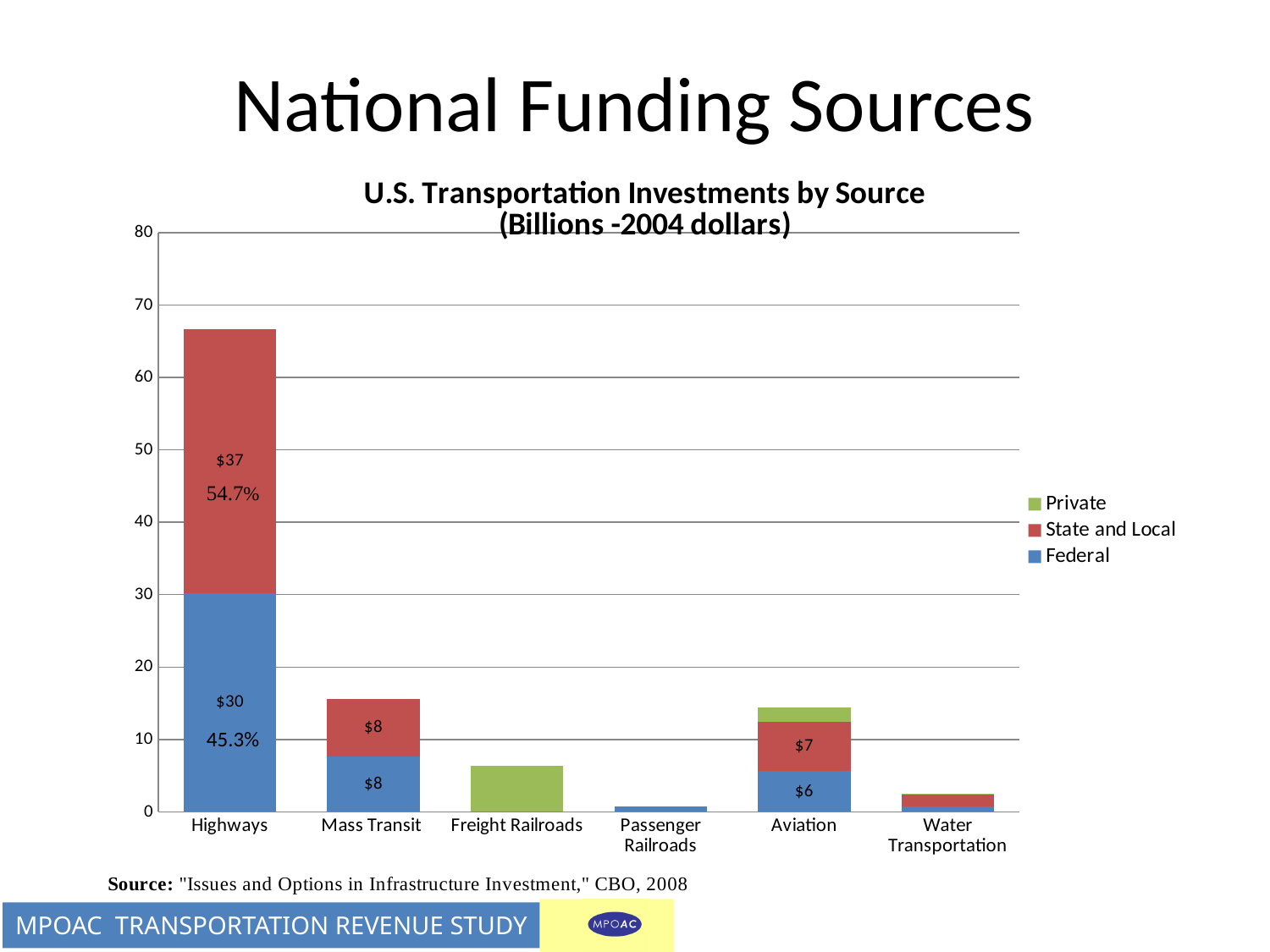
How many series does the legend list? 3 Which category has the highest total investment? Highways Which category has the lowest total investment? Passenger Railroads What is the Federal value for Highways? $30 For Aviation, which is larger: the Federal value or the State and Local value? State and Local What percentage label is shown on the Federal segment for Highways? 45.3% Is the total value for Freight Railroads greater or less than 10? less What type of chart is shown on the slide? Stacked bar chart How many categories are shown on the x axis? 6 What is the State and Local value for Aviation? $7 What is the State and Local value for Highways? $37 What is the difference between the State and Local and Federal values for Highways? $7